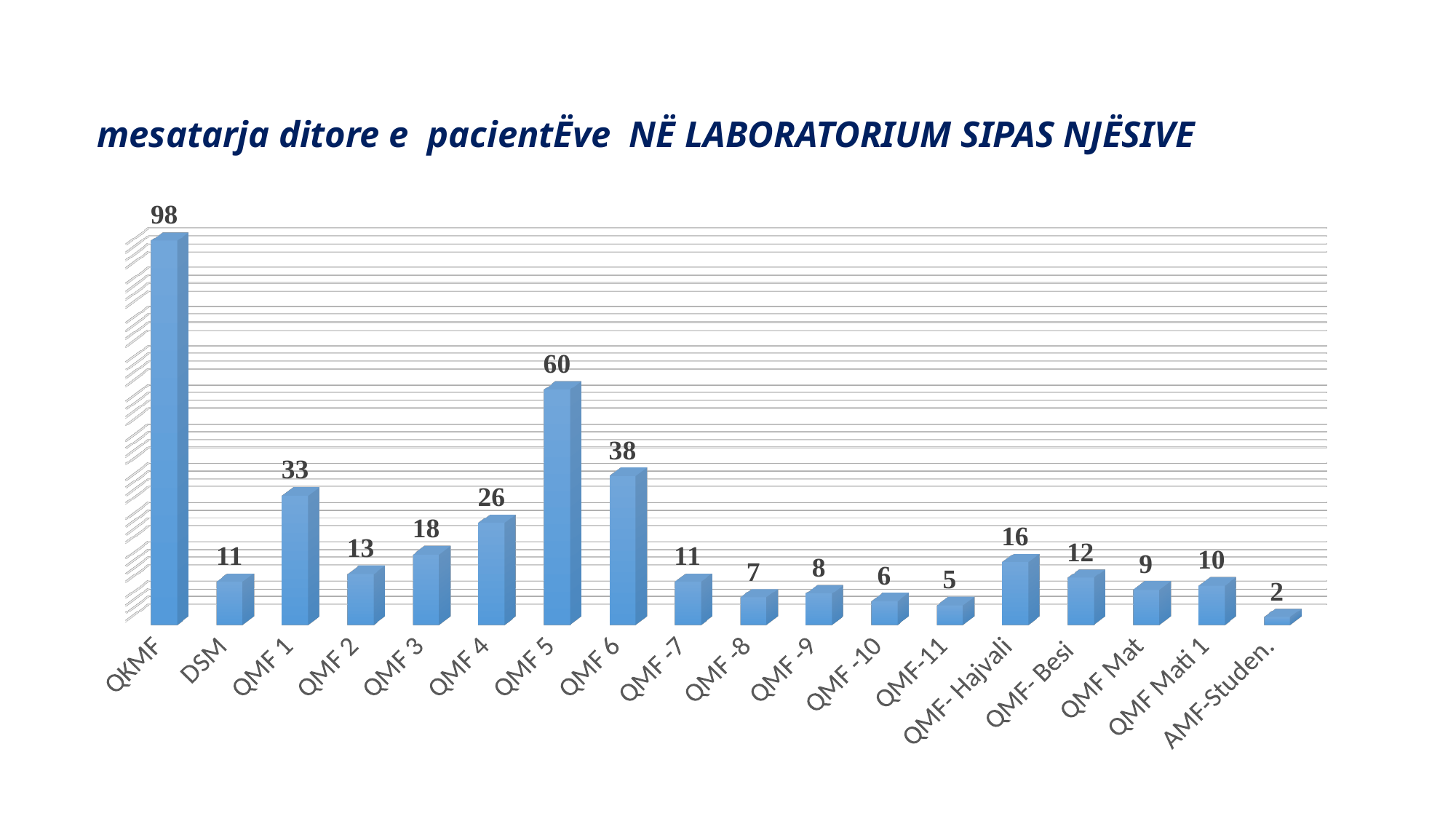
Which category has the highest value? QKMF What is the title of the chart? mesatarja ditore e pacientËve NË LABORATORIUM SIPAS NJËSIVE How many categories are shown on the x axis? 18 What is the difference between the values for QMF 5 and QMF 6? 22 What is the value for QMF 5? 60 What is the difference between the values for QMF 1 and QMF 4? 7 What kind of chart is shown on the slide? Bar chart Which category has the lowest value? AMF-Studen. Which is larger, the value for QMF 3 or the value for QMF- Besi? QMF 3 What is the value for QMF Mati 1? 10 What is the value for QMF- Hajvali? 16 What is the value for QKMF? 98